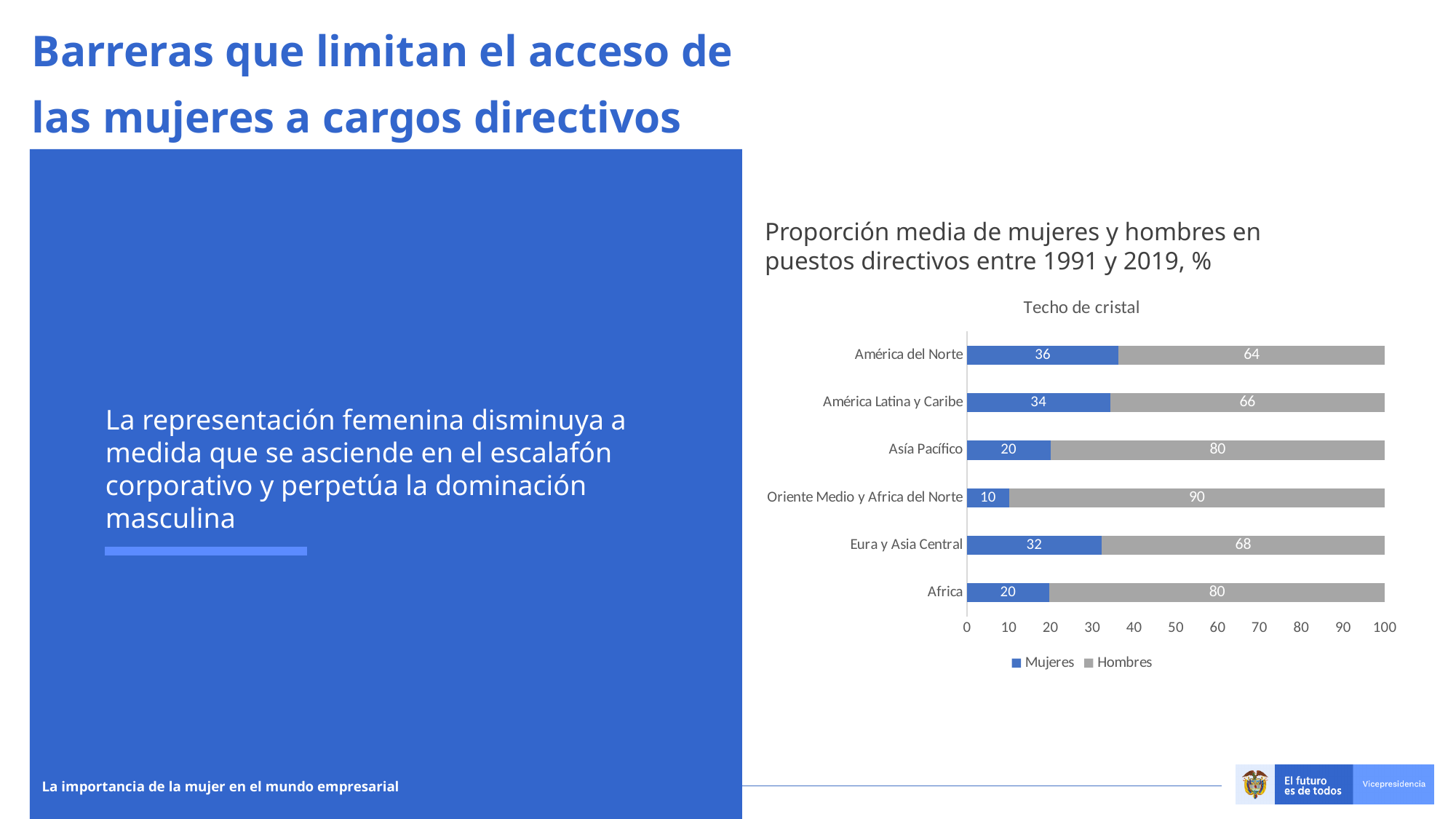
What is the Hombres value for Oriente Medio y Africa del Norte? 90 How many series does the legend list? 2 Which region has the lowest Mujeres value? Oriente Medio y Africa del Norte What is the Mujeres value for Eura y Asia Central? 32 How many regions are shown in the chart? 6 What is the difference between the Hombres and Mujeres values for América Latina y Caribe? 32 What is the title of the chart? Techo de cristal What kind of chart is shown? Stacked bar chart Which region has the highest Mujeres value? América del Norte Which is larger, the Mujeres value for Asía Pacífico or for Eura y Asia Central? Eura y Asia Central What is the Mujeres value for América del Norte? 36 What is the total of the stacked bar for Africa? 100